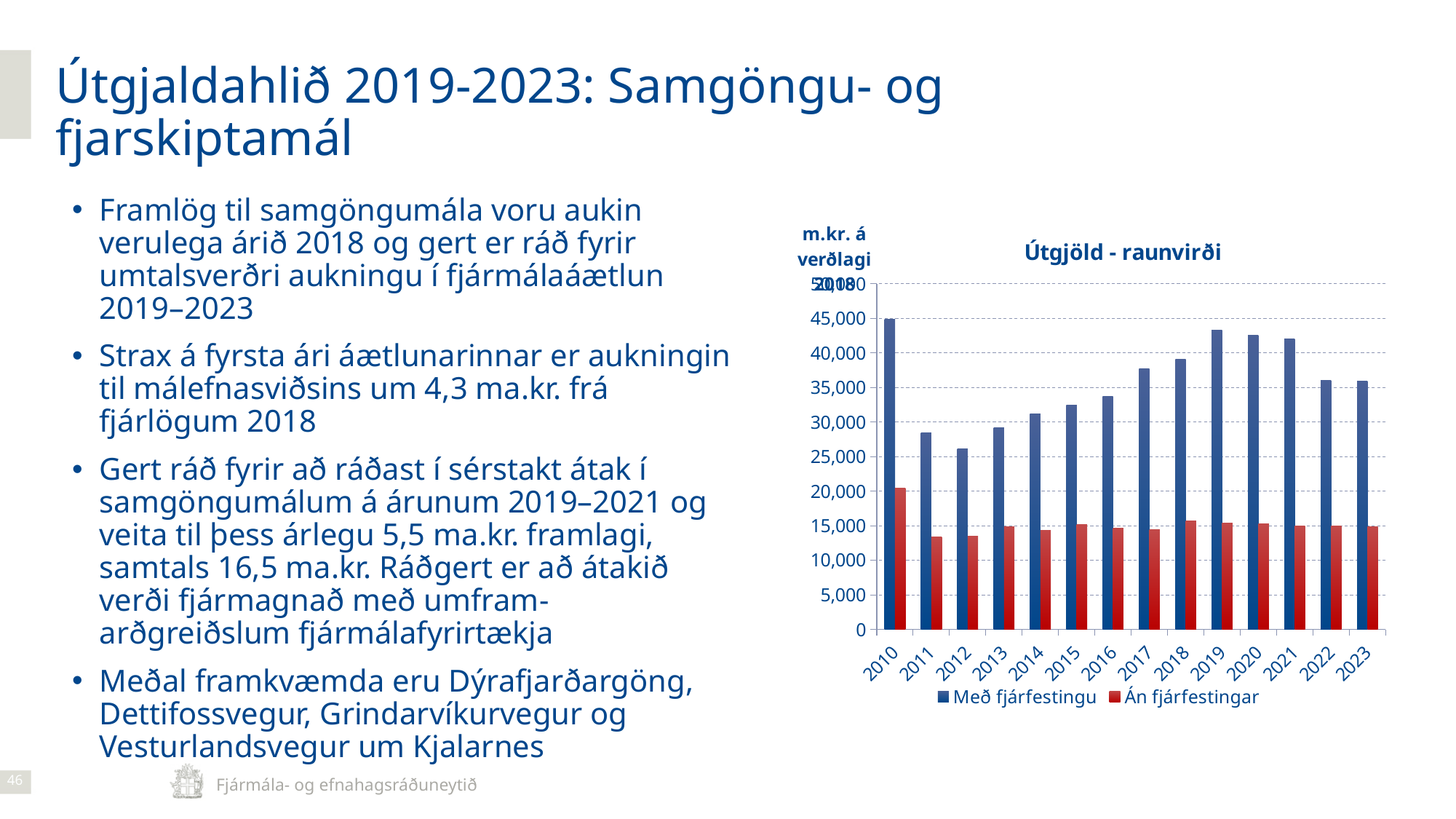
How many series does the chart legend list? 2 Which is larger for Með fjárfestingu: the value in 2017 or the value in 2018? 2018 Is the value for Með fjárfestingu in 2010 greater or less than 40,000? greater Which year has the highest value for Með fjárfestingu? 2010 What kind of chart is shown on the slide? bar chart Which series is shown in red in the chart? Án fjárfestingar Is the value for Með fjárfestingu in 2012 greater or less than 30,000? less Which year has the lowest value for Með fjárfestingu? 2012 What is the title of the chart? Útgjöld - raunvirði How many years are shown on the x axis of the chart? 14 Is the value for Án fjárfestingar in 2011 greater or less than 15,000? less Which year has the highest value for Án fjárfestingar? 2010